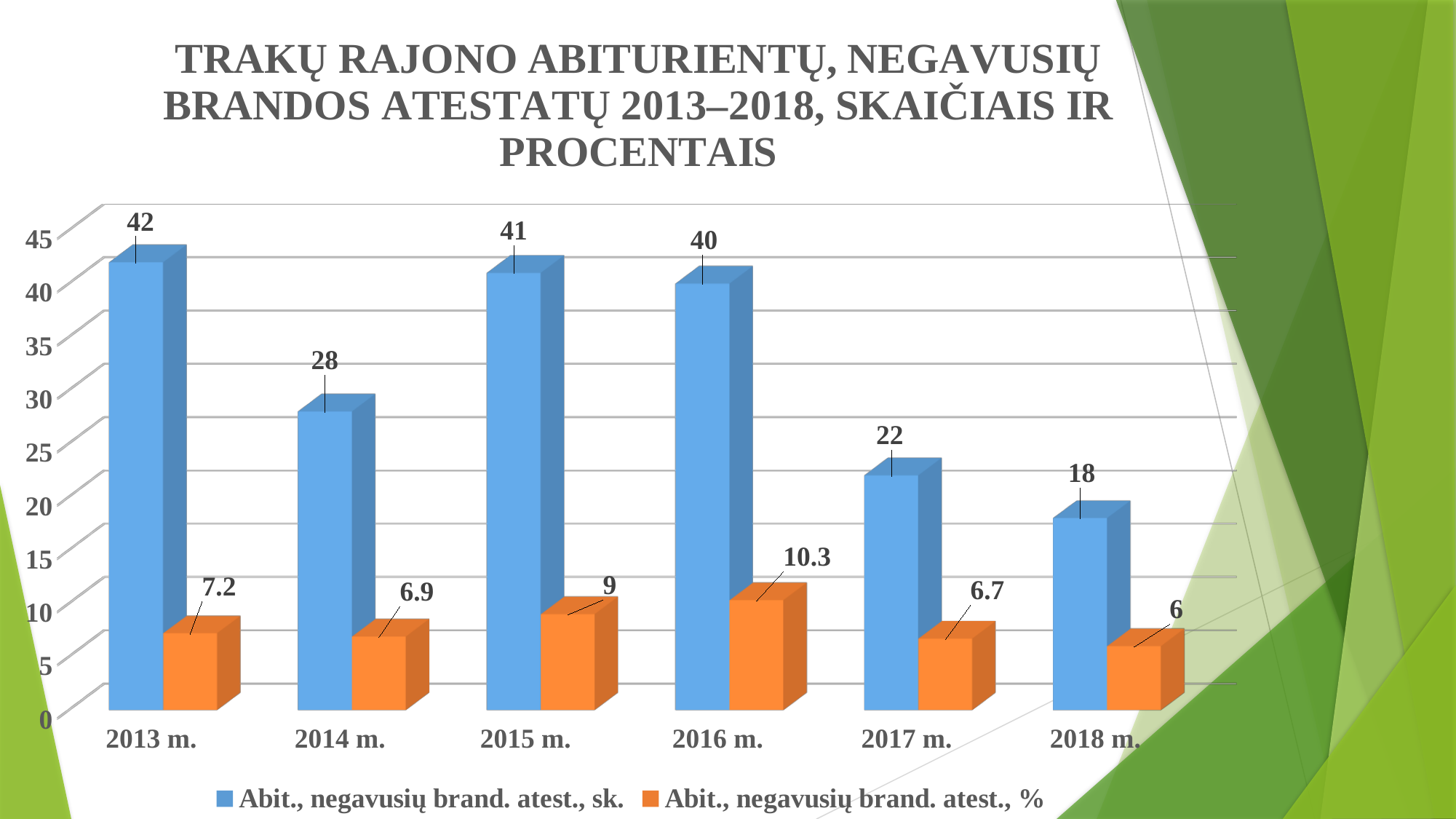
Is the value of 'Abit., negavusių brand. atest., sk.' for 2014 m. greater or less than 30? less How many series does the legend list? 2 What is the value of 'Abit., negavusių brand. atest., sk.' for 2013 m.? 42 How many years are shown on the x axis? 6 Which year has the lowest value for 'Abit., negavusių brand. atest., %'? 2018 m. Which year has the highest value for 'Abit., negavusių brand. atest., sk.'? 2013 m. What is the value of 'Abit., negavusių brand. atest., %' for 2016 m.? 10.3 What kind of chart is shown on the slide? bar chart What is the difference between the 'Abit., negavusių brand. atest., sk.' values for 2015 m. and 2017 m.? 19 Which colour represents 'Abit., negavusių brand. atest., %' in the legend? orange Which is larger: the 'Abit., negavusių brand. atest., %' value for 2013 m. or for 2014 m.? 2013 m. What is the value of 'Abit., negavusių brand. atest., sk.' for 2018 m.? 18